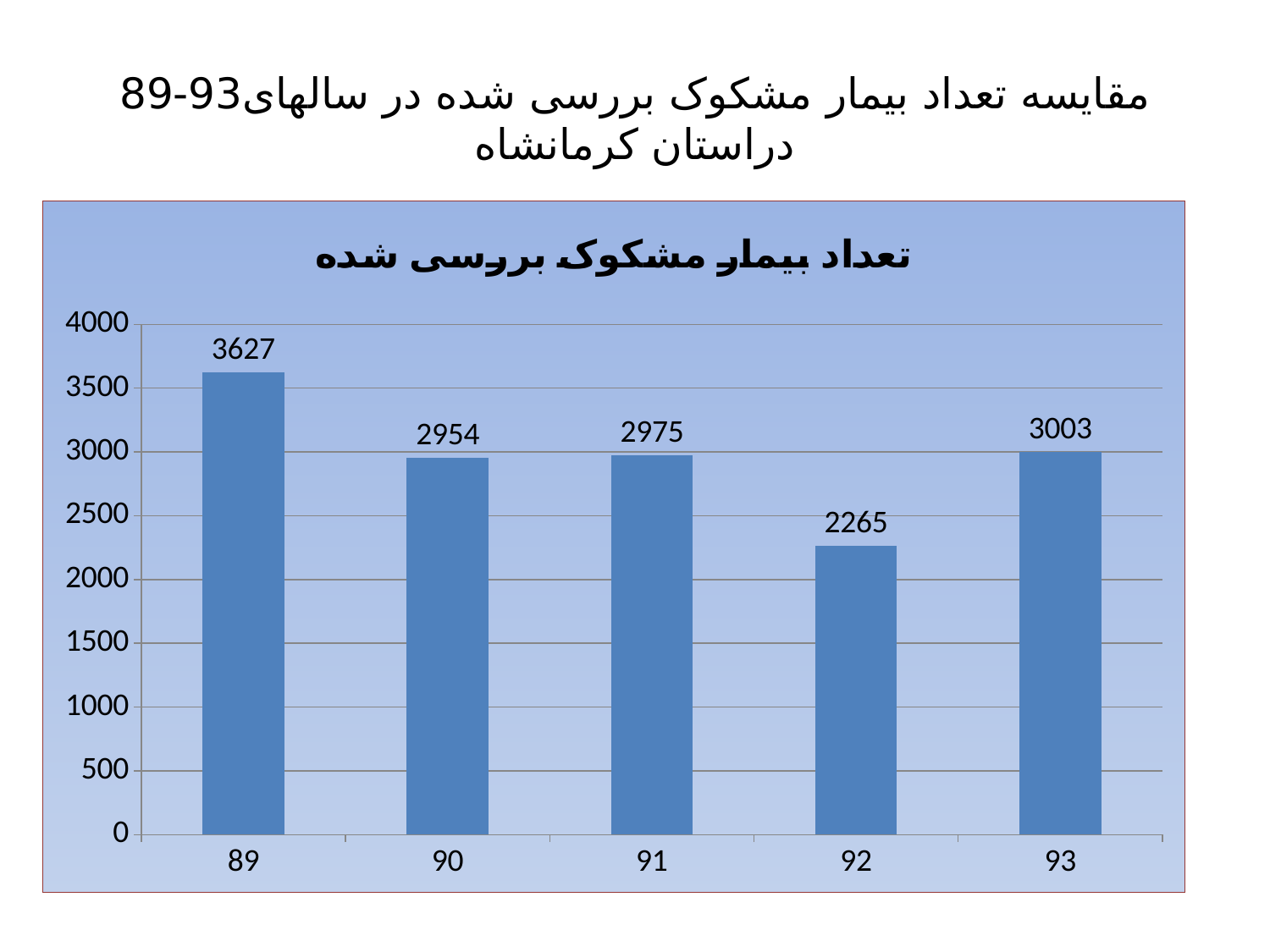
Which is larger, the value for year 91 or year 92? 91 Which year has the lowest value? 92 What is the value for year 93? 3003 What is the difference between the values for years 89 and 92? 1362 Does the value rise or fall from year 92 to year 93? rise Is the value for year 92 greater or less than 2500? less What is the difference between the values for years 93 and 90? 49 What is the value for year 92? 2265 What is the value for year 89? 3627 Which year has the highest value? 89 How many years are shown on the x axis? 5 What kind of chart is shown? bar chart